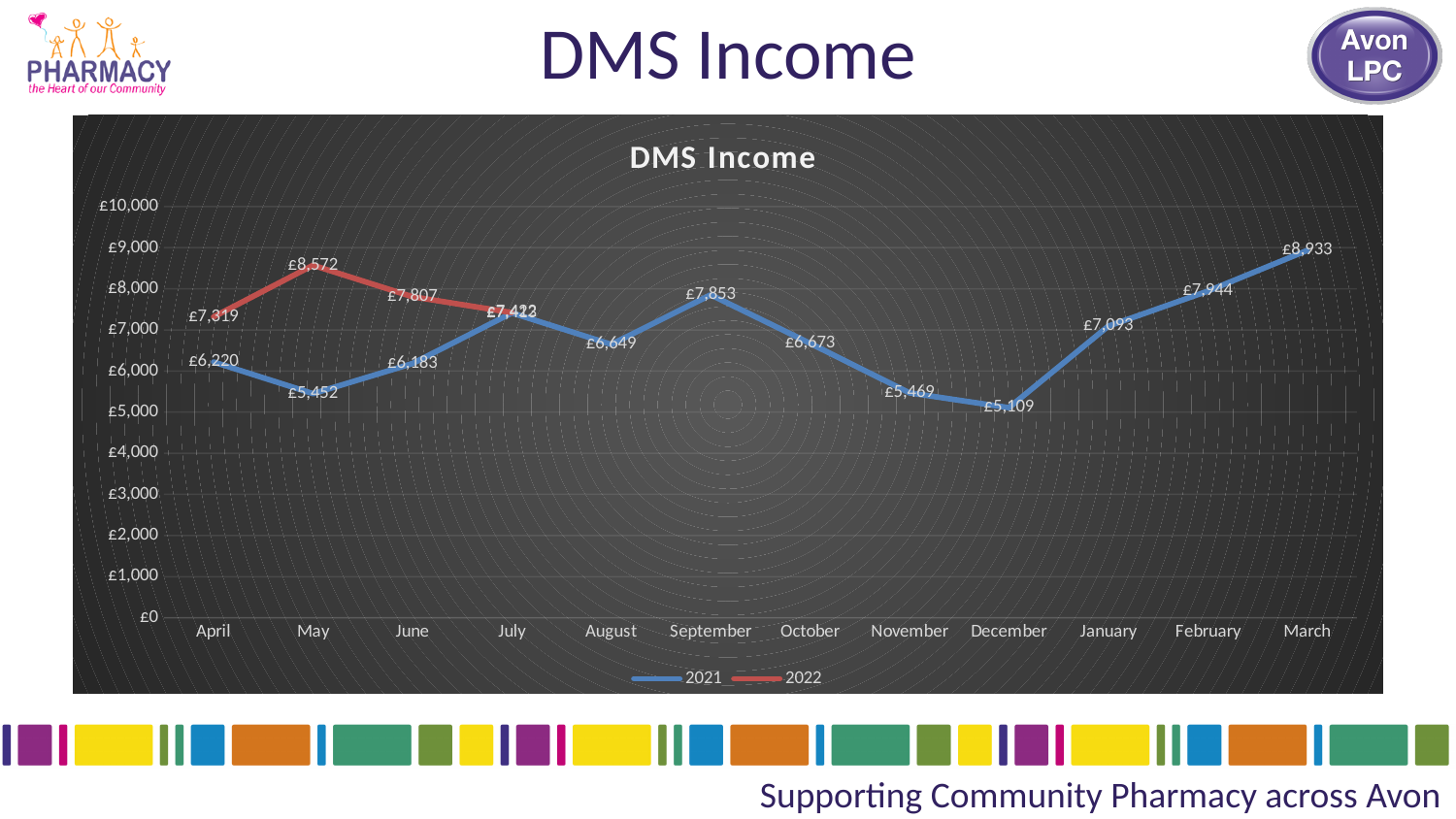
What is the difference between the 2022 DMS income in May and in April? £1,253 Does the 2021 DMS income rise or fall from December to March? rise What is the 2021 DMS income for September? £7,853 How many months are shown along the x axis? 12 What is the difference between the 2021 DMS income in March and in December? £3,824 What is the 2021 DMS income for March? £8,933 What is the 2022 DMS income for May? £8,572 How many series does the legend list? 2 In April, which series has the higher DMS income, 2021 or 2022? 2022 Which month has the lowest 2021 DMS income? December What kind of chart is shown on the slide? line chart Which month has the highest 2021 DMS income? March